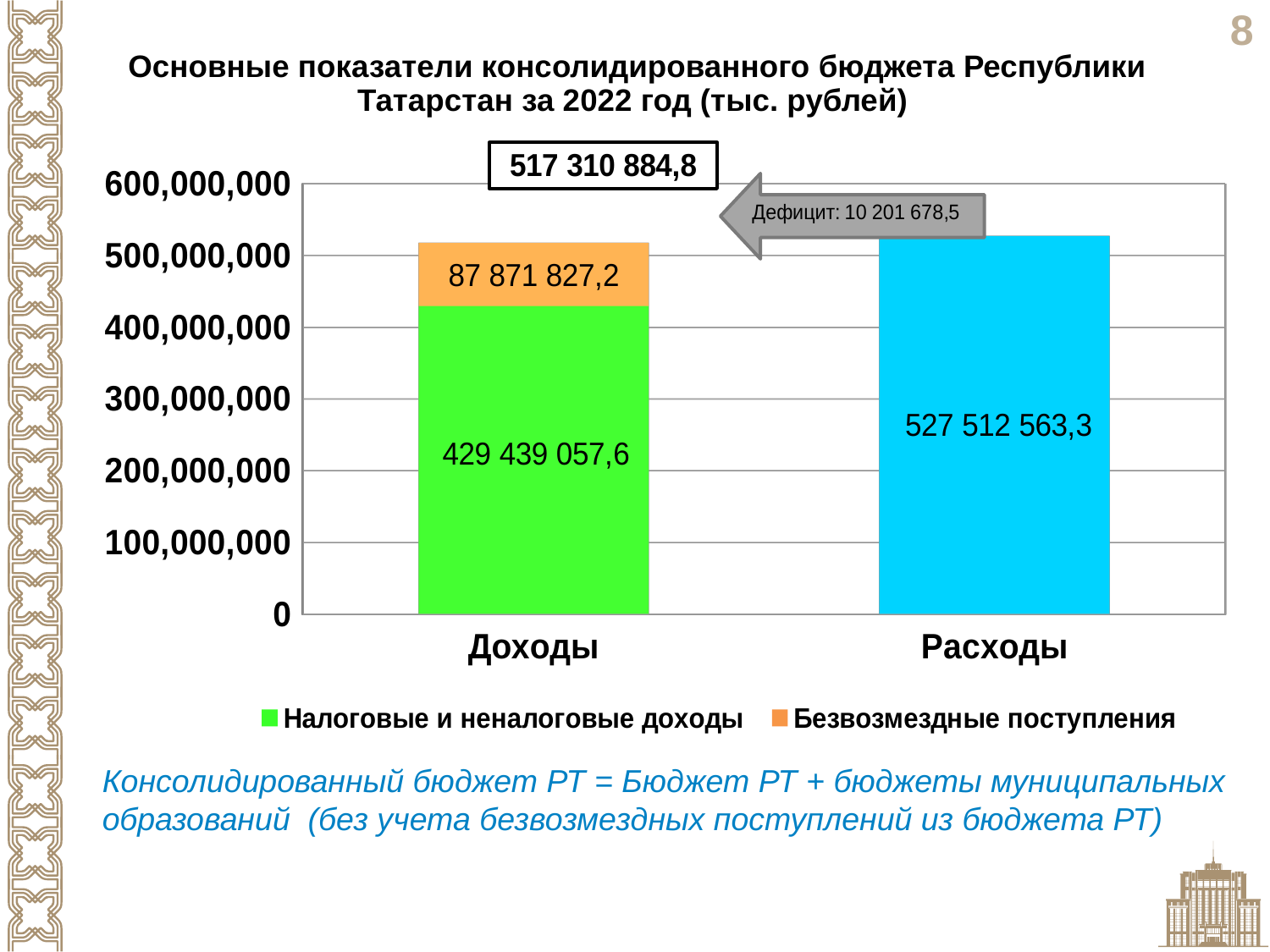
What value is shown for 'Расходы'? 527 512 563,3 What deficit value is shown on the slide? 10 201 678,5 What kind of chart is shown on the slide? Stacked bar chart What is the difference between 'Расходы' and the total 'Доходы'? 10 201 678,5 How many series does the legend list? 2 What is the value of the 'Налоговые и неналоговые доходы' segment in the 'Доходы' bar? 429 439 057,6 Which is larger, the total for 'Доходы' or the value for 'Расходы'? Расходы What is the total of the stacked 'Доходы' bar? 517 310 884,8 How many categories are shown on the x axis? 2 Is the 'Налоговые и неналоговые доходы' segment greater or less than 400,000,000? greater Is the value for 'Расходы' greater or less than 500,000,000? greater What is the value of the 'Безвозмездные поступления' segment in the 'Доходы' bar? 87 871 827,2